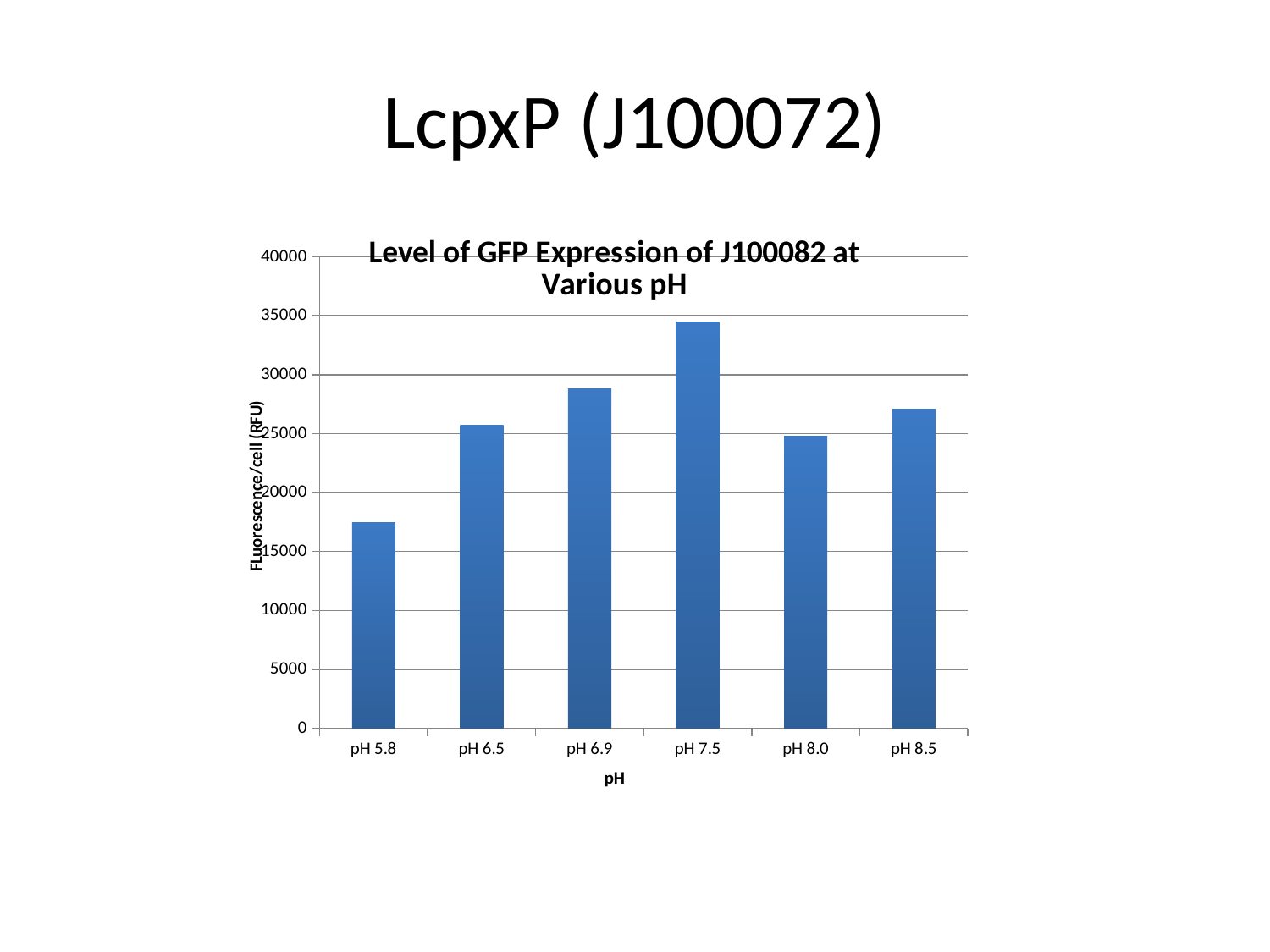
Which has a higher fluorescence per cell, pH 6.9 or pH 8.0? pH 6.9 Which pH has the highest fluorescence per cell? pH 7.5 Is the value for pH 7.5 greater or less than 30000? greater What is the title of the chart? Level of GFP Expression of J100082 at Various pH Is the value for pH 6.9 greater or less than 30000? less Which has a higher fluorescence per cell, pH 8.5 or pH 6.5? pH 8.5 Do the values rise or fall from pH 5.8 to pH 7.5? rise What kind of chart is shown on the slide? bar chart Which pH has the lowest fluorescence per cell? pH 5.8 Is the value for pH 5.8 greater or less than 20000? less How many pH categories are plotted on the chart? 6